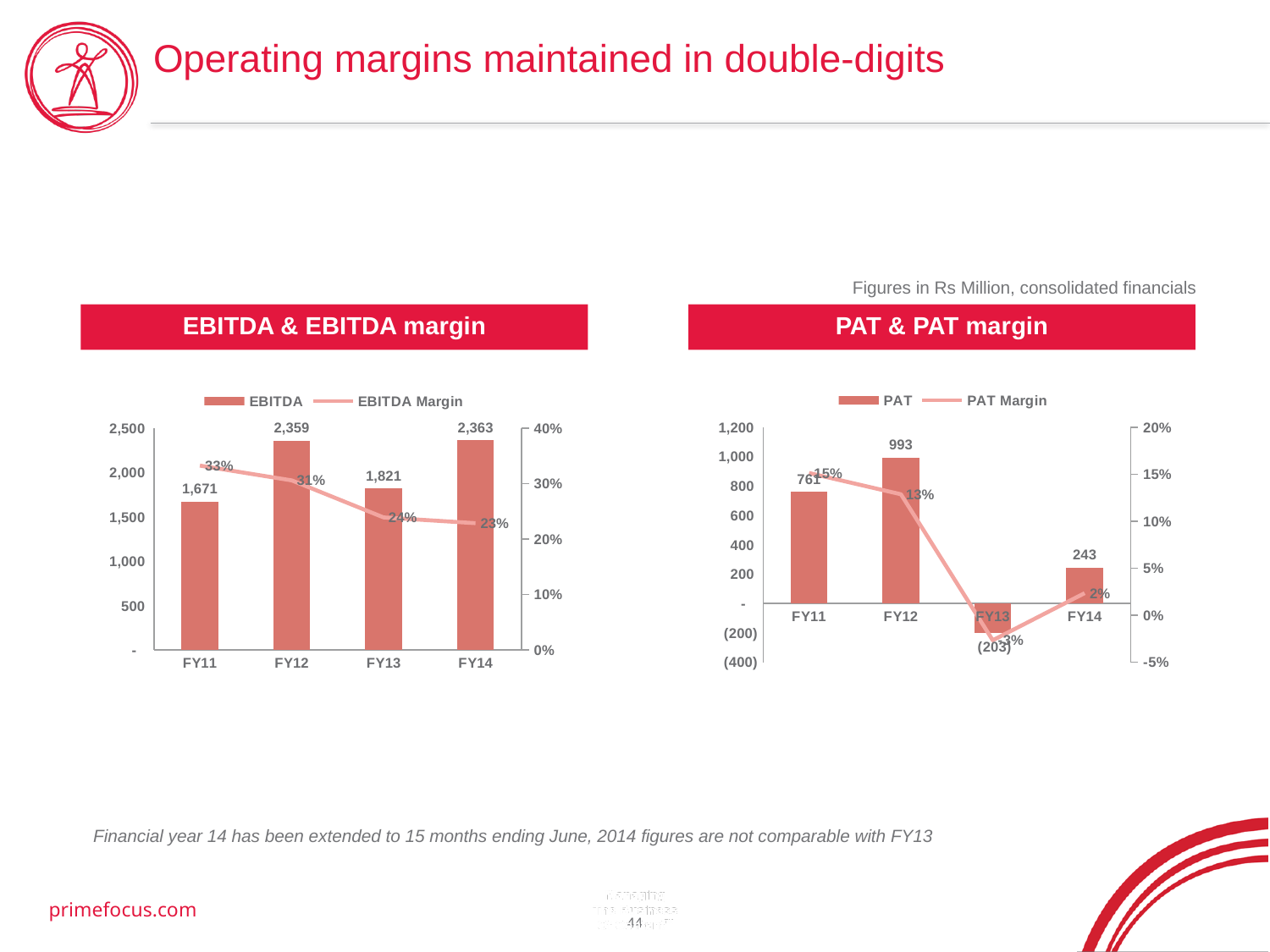
In the PAT & PAT margin chart, what is the PAT value for FY12? 993 In the PAT & PAT margin chart, what is the PAT value for FY13? (203) In the EBITDA & EBITDA margin chart, which year has the lowest EBITDA? FY11 In the EBITDA & EBITDA margin chart, how many series does the legend list? 2 In the PAT & PAT margin chart, which year has the highest PAT? FY12 In the EBITDA & EBITDA margin chart, what is the EBITDA value for FY12? 2,359 In the PAT & PAT margin chart, what is the PAT margin for FY11? 15% In the PAT & PAT margin chart, how many years are shown on the x axis? 4 In the PAT & PAT margin chart, which is larger, the PAT for FY11 or FY14? FY11 In the EBITDA & EBITDA margin chart, does the EBITDA margin rise or fall from FY11 to FY14? fall In the EBITDA & EBITDA margin chart, what is the EBITDA margin for FY13? 24% In the EBITDA & EBITDA margin chart, what is the difference between the EBITDA for FY13 and FY11? 150